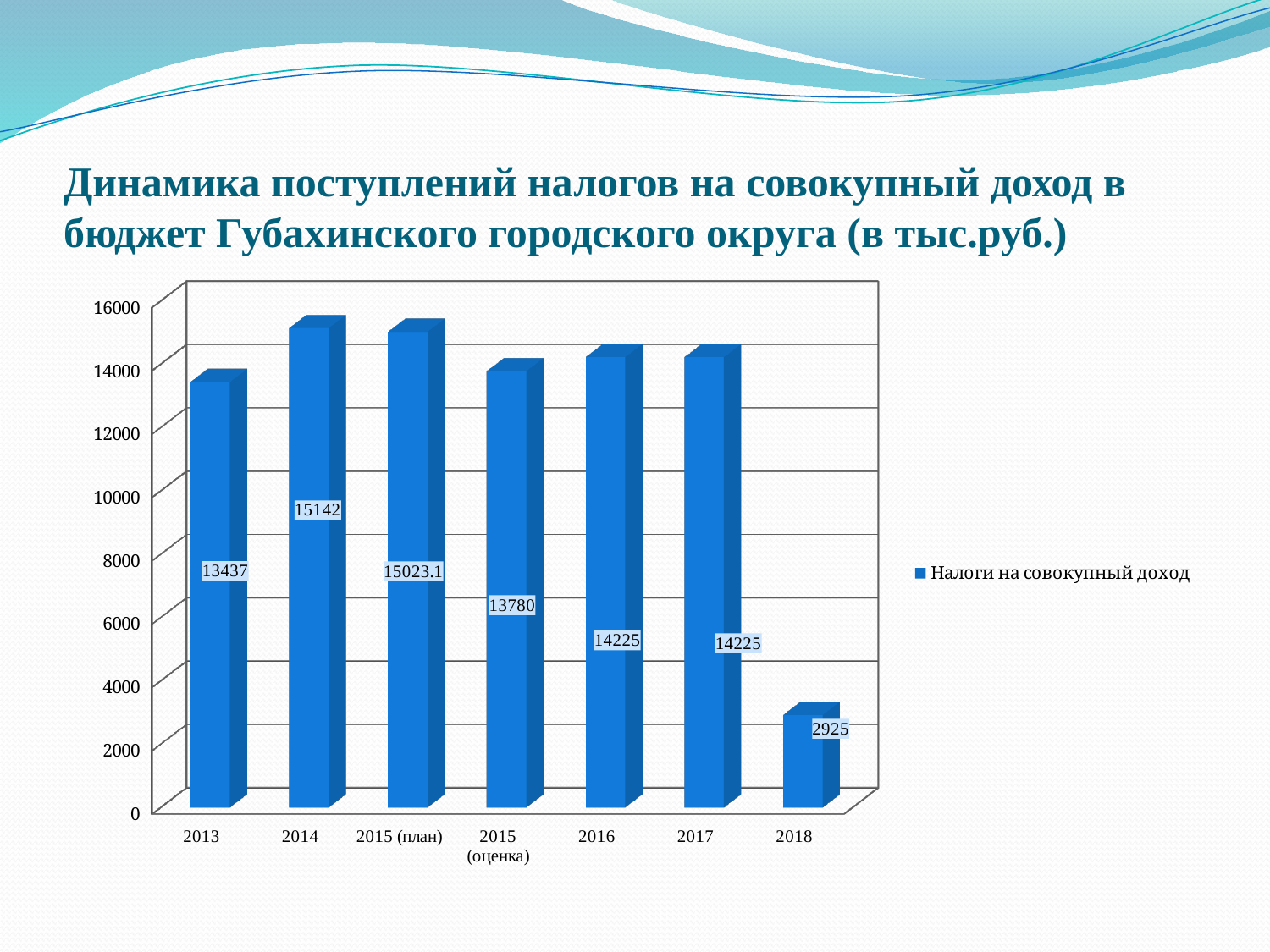
Which is larger, the value for 2015 (оценка) or the value for 2016? 2016 What is the legend entry for the series? Налоги на совокупный доход Is the value for 2017 greater or less than 14000? greater What kind of chart is shown? bar chart What is the value for 2018? 2925 Which category has the lowest value? 2018 What is the difference between the values for 2014 and 2013? 1705 What is the value for 2013? 13437 What is the value for 2015 (план)? 15023.1 How many categories are shown on the x axis? 7 How many series does the legend list? 1 Which category has the highest value? 2014